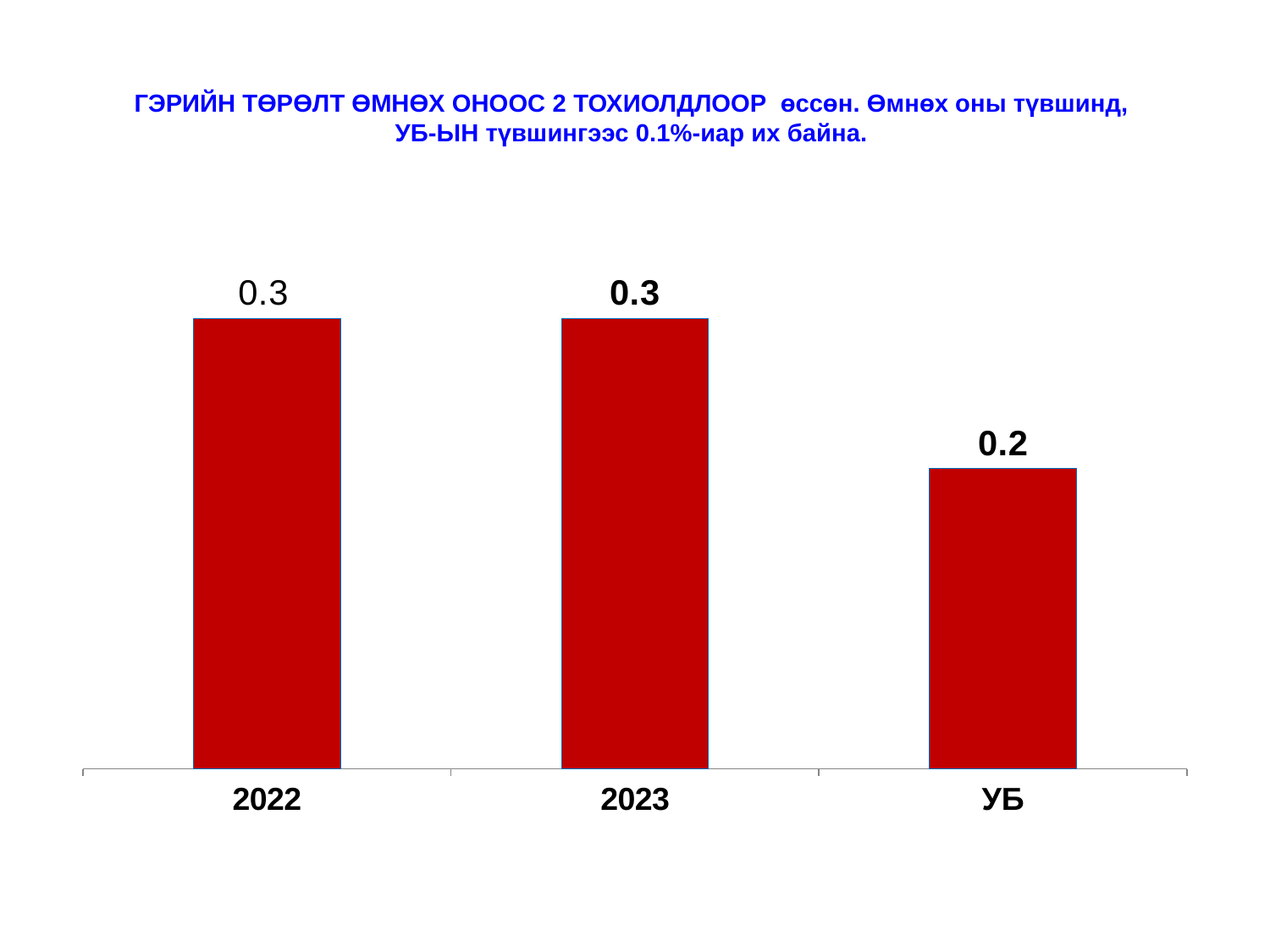
What is the difference between the value for 2023 and the value for УБ? 0.1 What colour are the bars in the chart? Red Do the values rise or fall from 2023 to УБ? Fall Which category has the lowest value? УБ What is the difference between the value for 2022 and the value for 2023? 0 What is the value for 2023? 0.3 Which is larger, the value for 2023 or the value for УБ? 2023 How many bars are shown in the chart? 3 What is the value for УБ? 0.2 What is the value for 2022? 0.3 Which is larger, the value for 2022 or the value for УБ? 2022 What kind of chart is shown on the slide? Bar chart